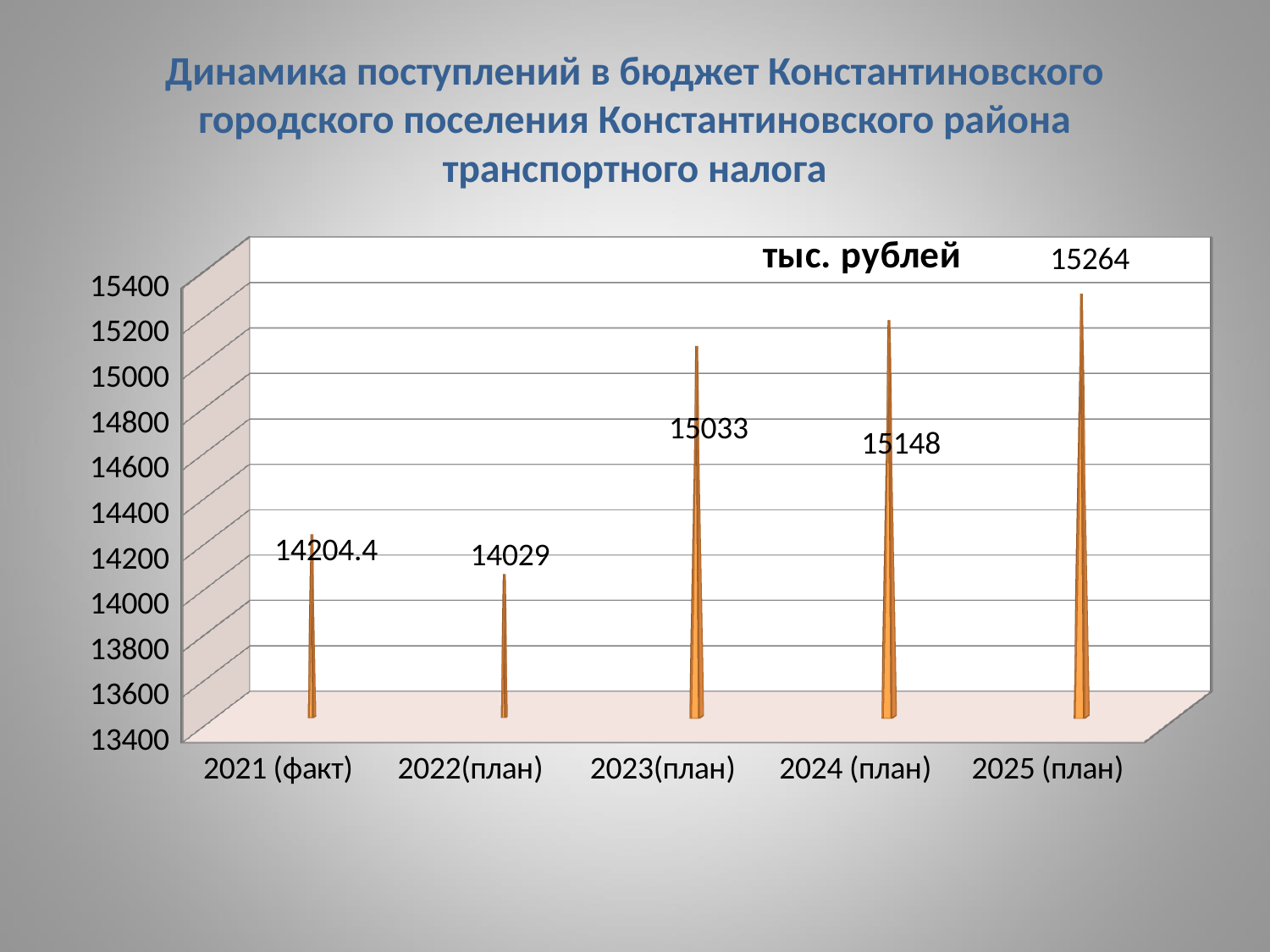
How many categories are shown on the x axis? 5 What unit of measurement is indicated on the chart? тыс. рублей What is the value for 2021 (факт)? 14204.4 What is the value for 2023(план)? 15033 What kind of chart is shown on the slide? bar chart What is the value for 2025 (план)? 15264 What is the value for 2022(план)? 14029 Which category has the highest value? 2025 (план) Which category has the lowest value? 2022(план) Which is larger, the value for 2021 (факт) or the value for 2022(план)? 2021 (факт) What is the difference between the values for 2025 (план) and 2024 (план)? 116 What is the difference between the values for 2023(план) and 2022(план)? 1004